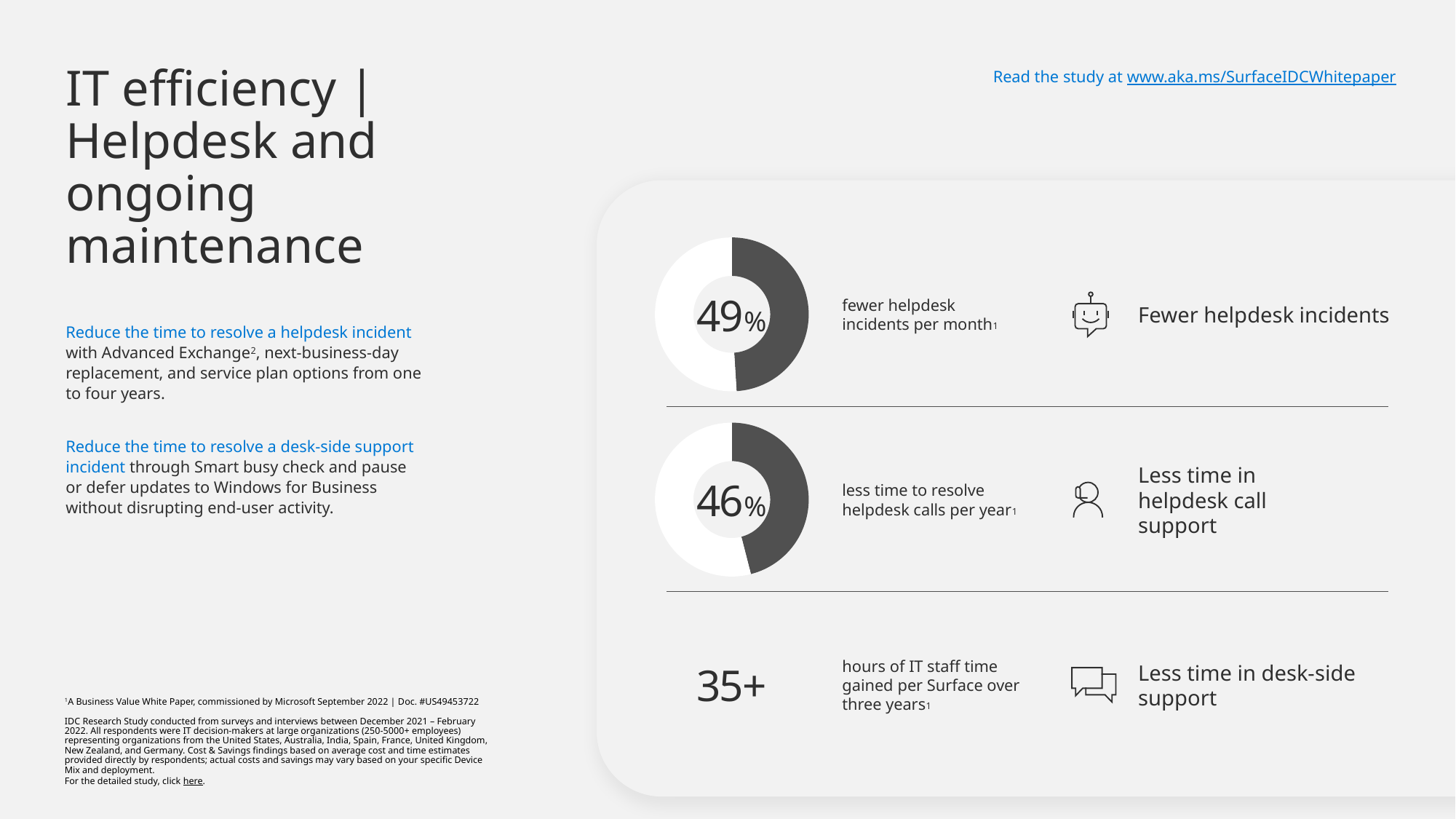
What colour is the filled segment in the donut charts? dark grey Which donut chart shows the larger percentage, the top one (fewer helpdesk incidents per month) or the middle one (less time to resolve helpdesk calls per year)? the top one (fewer helpdesk incidents per month) What metric does the top donut chart represent? fewer helpdesk incidents per month What kind of chart is used to show the 49% and 46% figures on the slide? donut chart How many donut charts are shown on the slide? 2 In the top donut chart, what share of the ring is filled by the dark segment? 49% In the top donut chart, what percentage is shown for fewer helpdesk incidents per month? 49% In the middle donut chart, what share of the ring is filled by the dark segment? 46% In the middle donut chart, what percentage is shown for less time to resolve helpdesk calls per year? 46% What is the difference between the percentage in the top donut chart and the percentage in the middle donut chart? 3% Is the value shown in the top donut chart greater or less than 50%? less Which of the two donut charts shows the lowest percentage? the middle one (less time to resolve helpdesk calls per year)